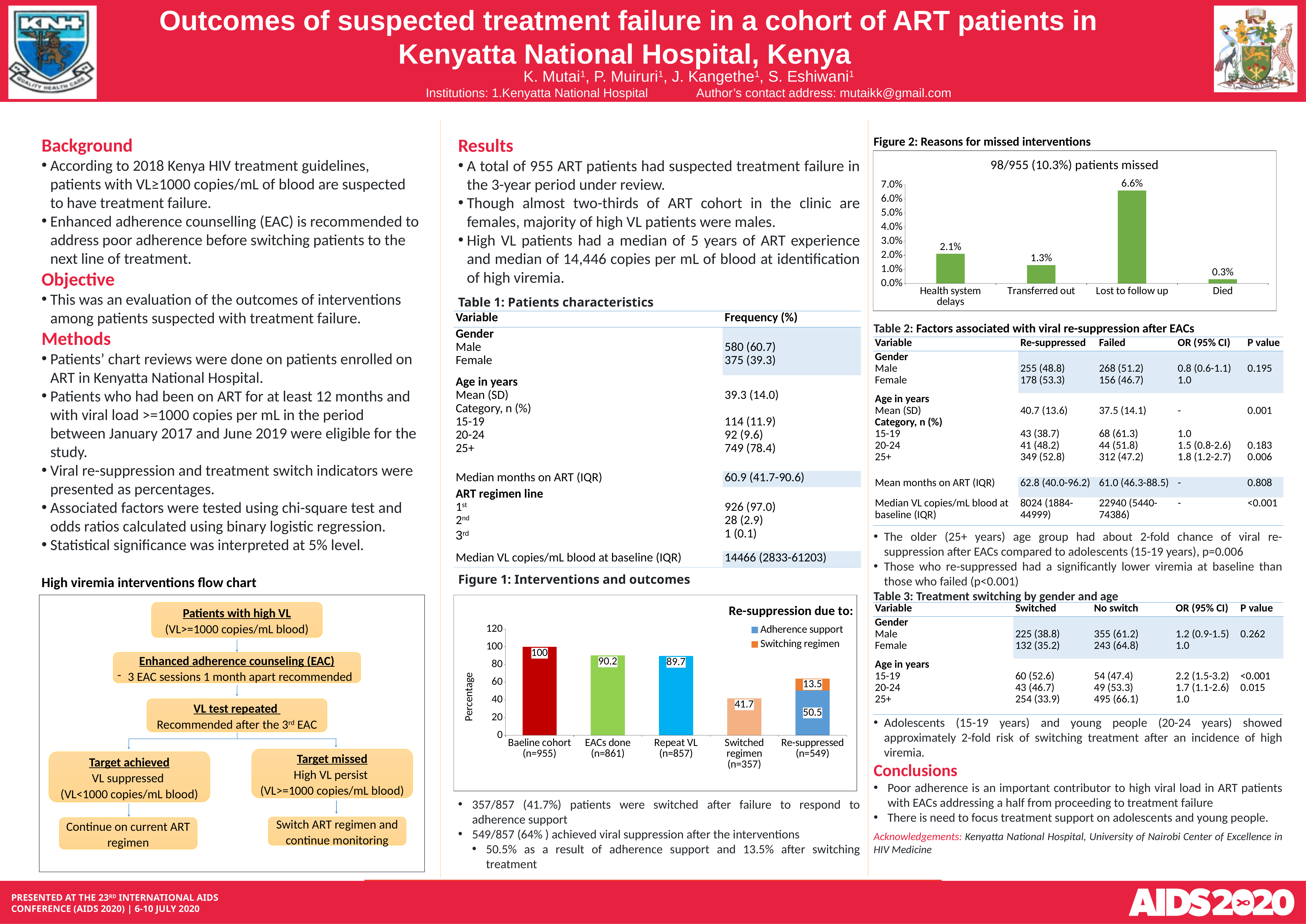
In Figure 2: Reasons for missed interventions, how many reasons are shown on the x axis? 4 In Figure 1: Interventions and outcomes, what is the value for Switched regimen (n=357)? 41.7 What kind of chart is Figure 2: Reasons for missed interventions? Bar chart In Figure 2: Reasons for missed interventions, what is the difference between Lost to follow up and Transferred out? 5.3% In Figure 1: Interventions and outcomes, what is the value for EACs done (n=861)? 90.2 In Figure 1: Interventions and outcomes, which is larger, the value for EACs done or the value for Repeat VL? EACs done In Figure 2: Reasons for missed interventions, which reason has the lowest value? Died In Figure 2: Reasons for missed interventions, which reason has the highest value? Lost to follow up In Figure 2: Reasons for missed interventions, what is the value for Lost to follow up? 6.6% In Figure 2: Reasons for missed interventions, what is the value for Health system delays? 2.1% In Figure 1: Interventions and outcomes, how many series does the legend list? 2 In Figure 1: Interventions and outcomes, what is the total of the stacked Re-suppressed (n=549) bar? 64